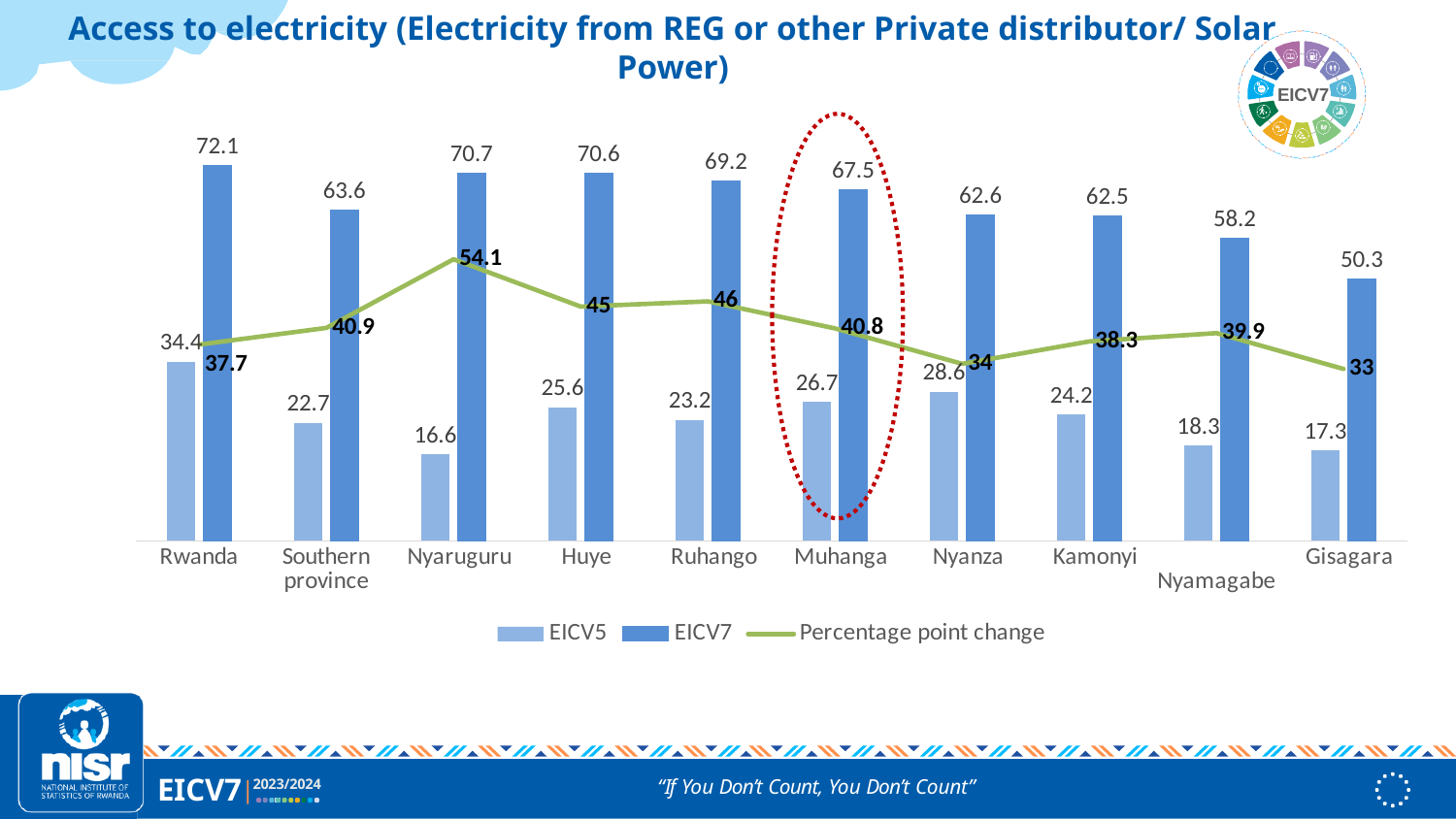
What is the difference between the EICV7 and EICV5 values for Rwanda? 37.7 How many series does the legend list? 3 What kind of chart is this? Bar chart with a line How many categories are shown on the x axis? 10 Which has the larger EICV7 value, Kamonyi or Gisagara? Kamonyi What is the EICV5 value for Nyaruguru? 16.6 What is the percentage point change for Nyaruguru? 54.1 Which category has the lowest EICV5 value? Nyaruguru Which category has the lowest percentage point change? Gisagara What is the EICV7 value for Muhanga? 67.5 Which category has the highest EICV7 value? Rwanda What is the EICV5 value for Nyamagabe? 18.3